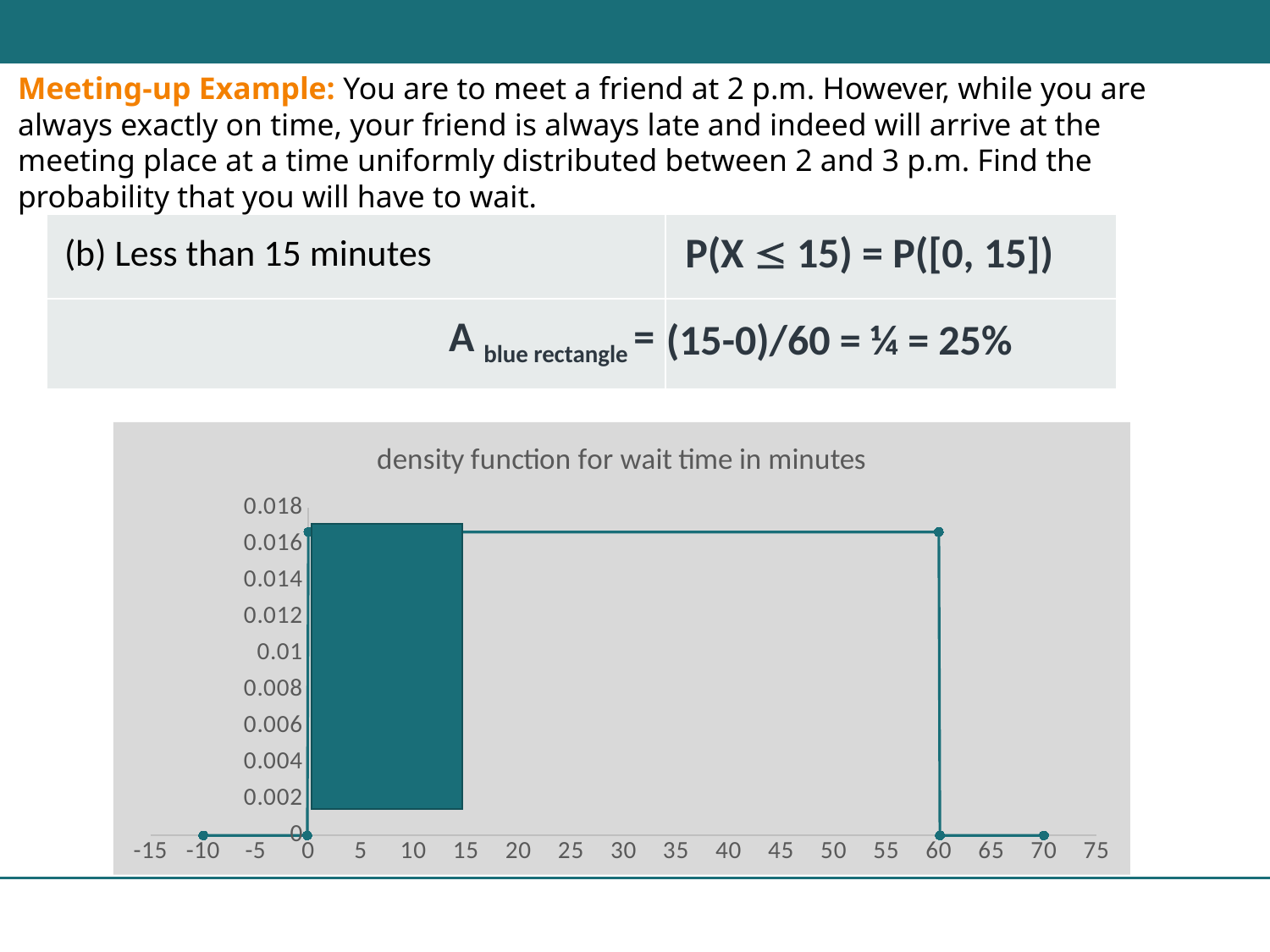
What is the title of the chart? density function for wait time in minutes What is the value of the density function at x = -10? 0 Is the value of the density function at x = 5 greater or less than 0.014? greater What kind of chart is shown on the slide? line chart At what x-axis value does the density function drop back down to 0? 60 What is the value of the density function at x = 70? 0 Is the value of the density function at x = 65 greater or less than 0.01? less Between x = 0 and x = 60, does the density function rise, fall, or stay constant? stay constant At what x-axis value does the density function rise from 0 to its constant level? 0 Is the value of the density function at x = 30 greater or less than 0.01? greater Over which range of x-axis values is the shaded rectangle drawn? 0 to 15 Which is larger: the density function value at x = 10 or at x = 65? x = 10